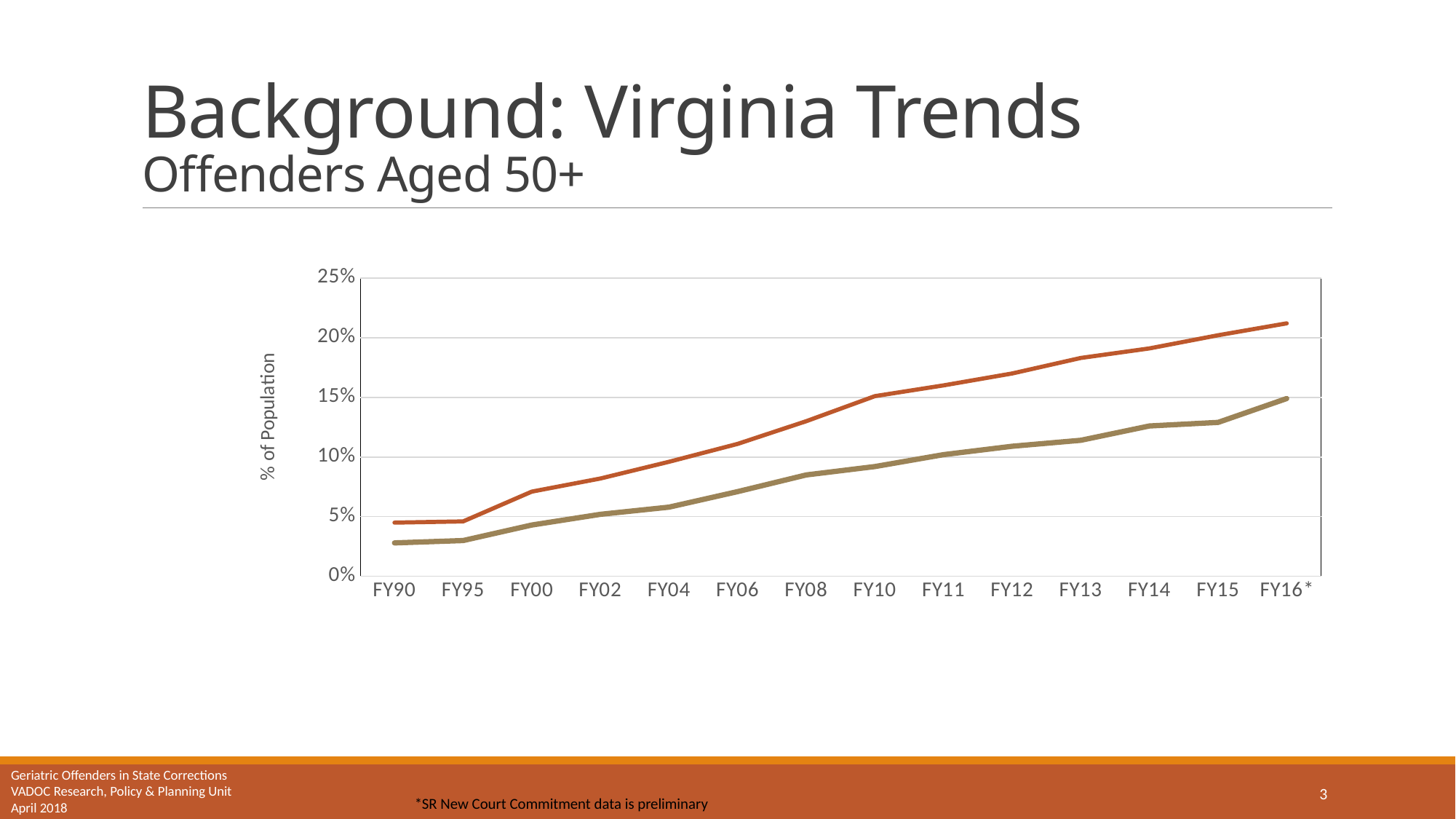
Do the values of the brown line rise or fall from FY90 to FY16*? rise Is the value of the orange line at FY16* greater or less than 20%? greater Do the values of the orange line rise or fall from FY90 to FY16*? rise Is the value of the brown line at FY90 greater or less than 5%? less How many fiscal-year points are plotted along the x axis? 14 What kind of chart is shown on the slide? line chart Is the value of the brown line at FY14 greater or less than 10%? greater At FY16*, which line has the higher value, the orange line or the brown line? the orange line How many lines are plotted on the chart? 2 What is the label on the vertical axis? % of Population